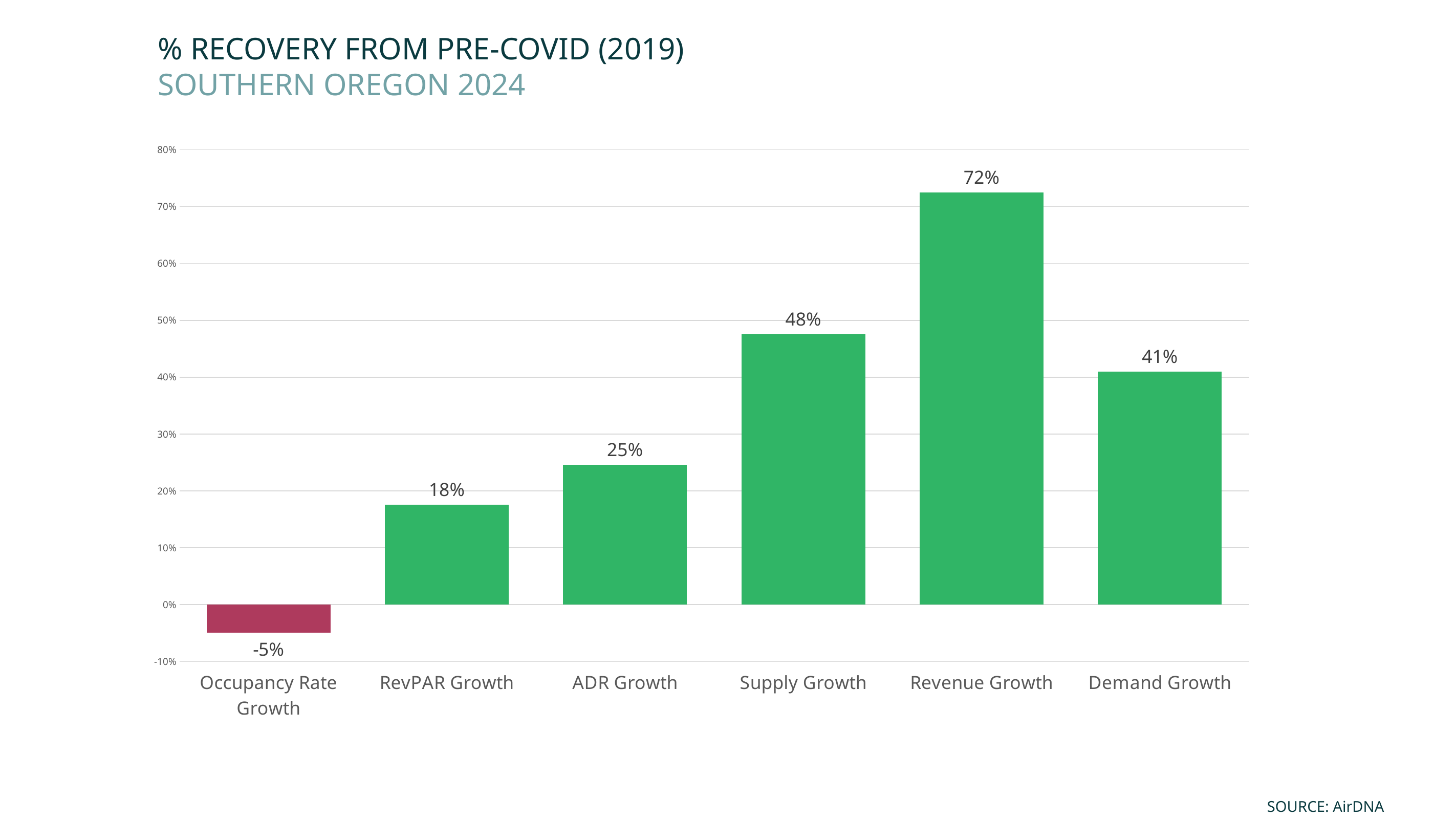
What is the value for Occupancy Rate Growth? -5% Which bar is shown in a different colour (red) from the others? Occupancy Rate Growth What is the value for Supply Growth? 48% Which is larger, Supply Growth or Demand Growth? Supply Growth What is the difference between Revenue Growth and Demand Growth? 31% What kind of chart is shown on the slide? bar chart Which category has the lowest value? Occupancy Rate Growth How many categories are shown on the chart? 6 Which category has the highest value? Revenue Growth What is the value for Revenue Growth? 72% Is the value for RevPAR Growth greater or less than 20%? less What is the value for ADR Growth? 25%